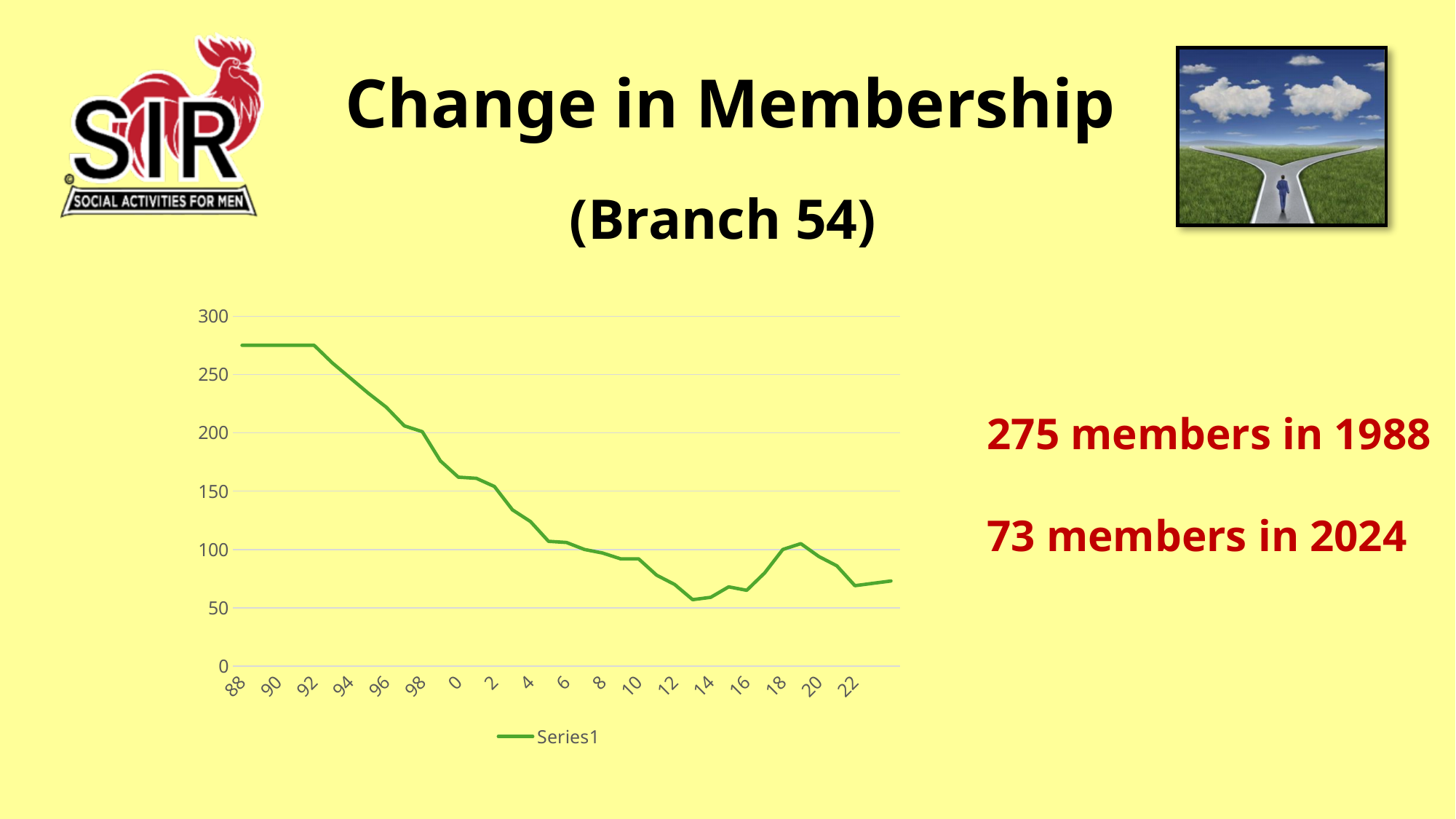
Is the value for 14 greater or less than 100? less What kind of chart is shown on the slide? line chart How many series does the chart legend list? 1 How many members did Branch 54 have in 2024? 73 What colour is the line in the chart? green By how much did membership decrease from 1988 to 2024? 202 Is the value for 92 greater or less than 250? greater How many members did Branch 54 have in 1988? 275 Is the value for 4 greater or less than 150? less What is the name of the series shown in the chart legend? Series1 Overall, do the membership values rise or fall from 1988 to 2024? fall